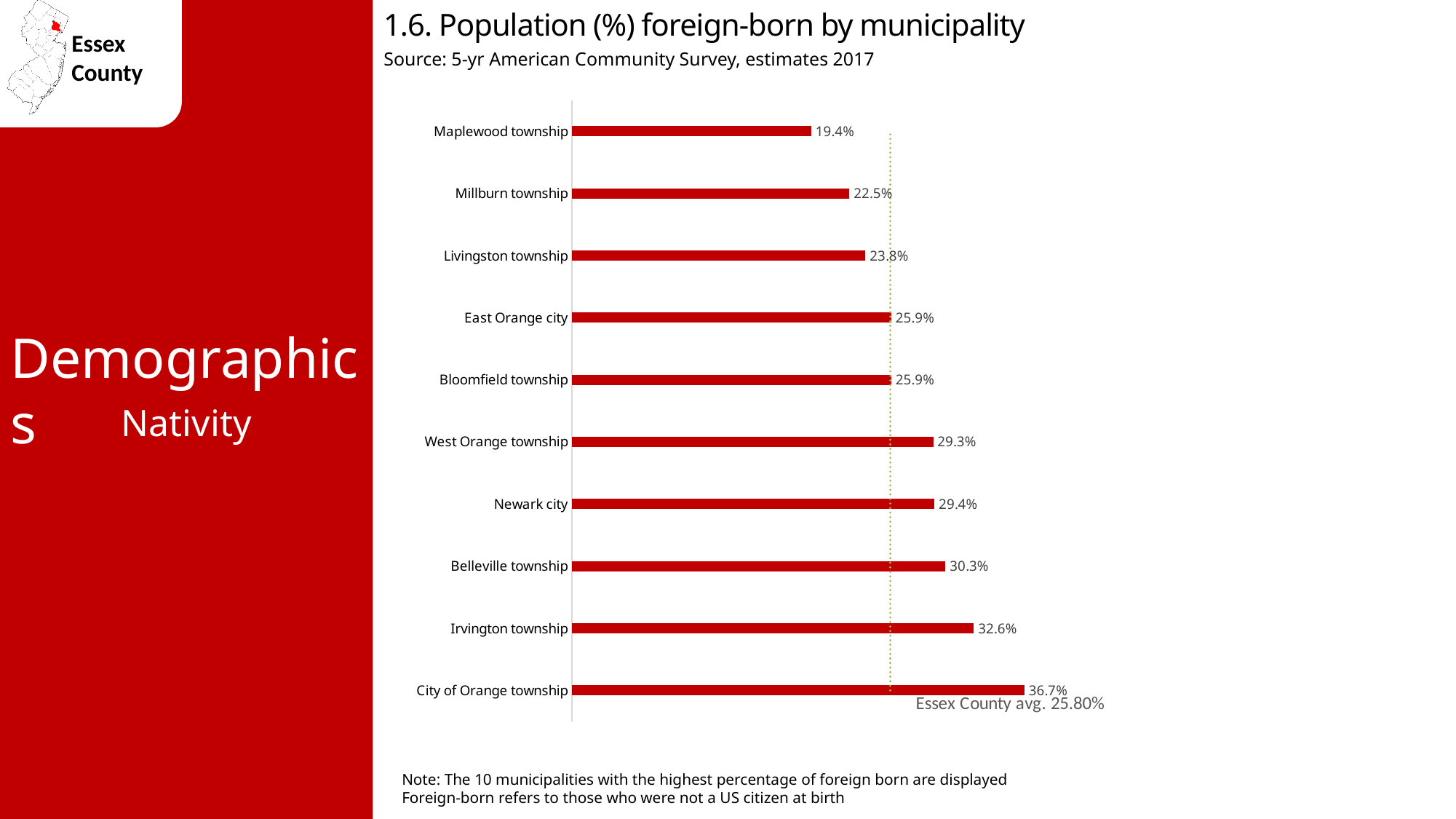
What is the difference in foreign-born percentage between Belleville township and Livingston township? 6.5% What is the foreign-born percentage for Irvington township? 32.6% Which has a higher foreign-born percentage, Millburn township or Livingston township? Livingston township What is the difference in foreign-born percentage between City of Orange township and Maplewood township? 17.3% What is the foreign-born percentage for Maplewood township? 19.4% What is the Essex County average foreign-born percentage shown by the dotted line? 25.80% Which has a higher foreign-born percentage, Irvington township or Belleville township? Irvington township Which municipality has the lowest foreign-born percentage? Maplewood township What kind of chart is shown on the slide? Bar chart Which municipality has the highest foreign-born percentage? City of Orange township What is the foreign-born percentage for Newark city? 29.4% How many municipalities are shown in the chart? 10